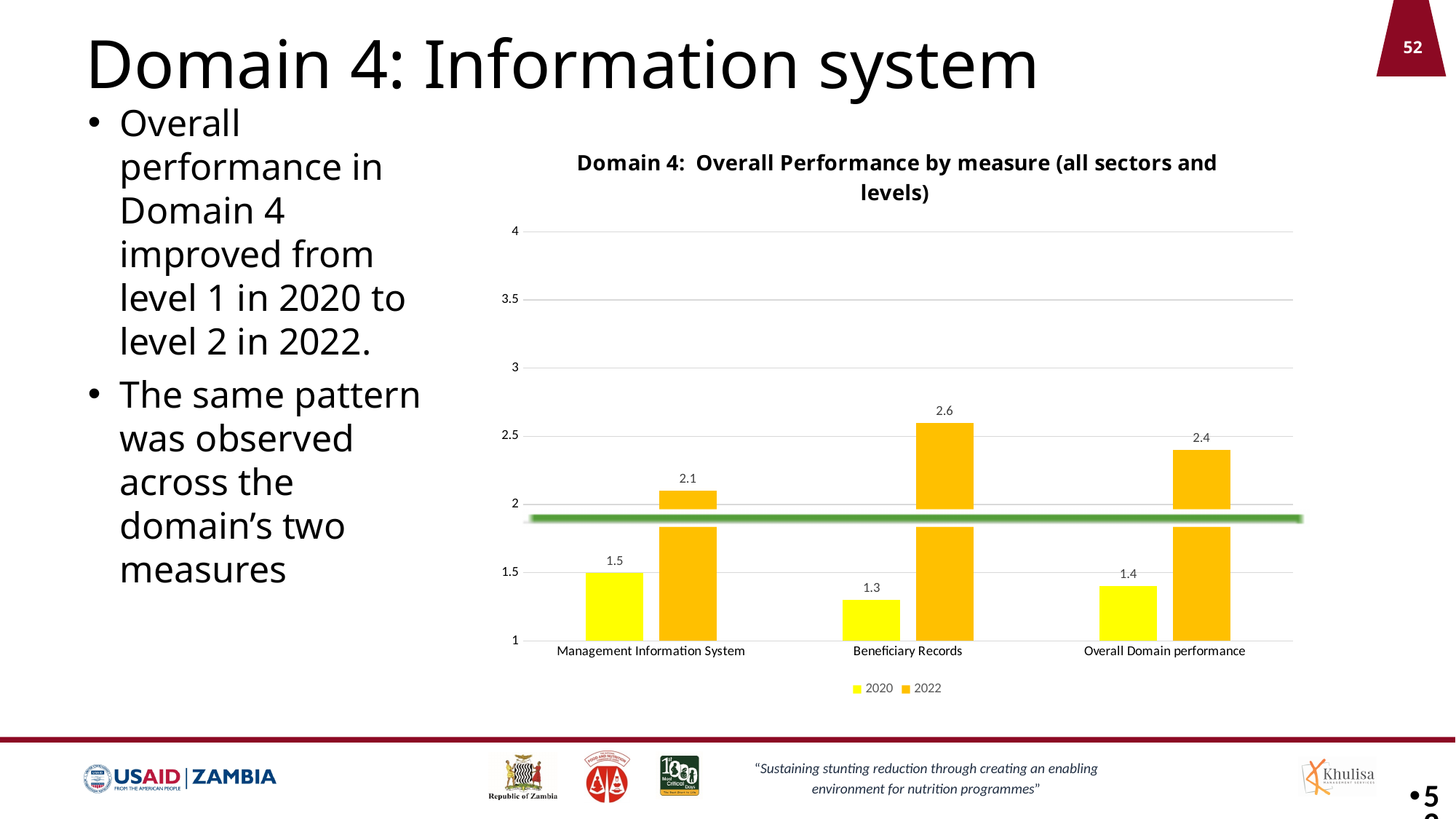
What is the difference between the 2022 and 2020 values for Overall Domain performance? 1.0 Which category has the lowest 2020 value? Beneficiary Records What kind of chart is shown on the slide? Bar chart How many categories are shown on the x axis? 3 What is the difference between the 2022 and 2020 values for Beneficiary Records? 1.3 What is the 2022 value for Beneficiary Records? 2.6 What is the 2022 value for Overall Domain performance? 2.4 Which series is shown in yellow in the legend? 2020 How many series does the legend list? 2 What is the 2020 value for Management Information System? 1.5 Which is larger, the 2022 value for Management Information System or the 2022 value for Overall Domain performance? Overall Domain performance Which category has the highest 2022 value? Beneficiary Records